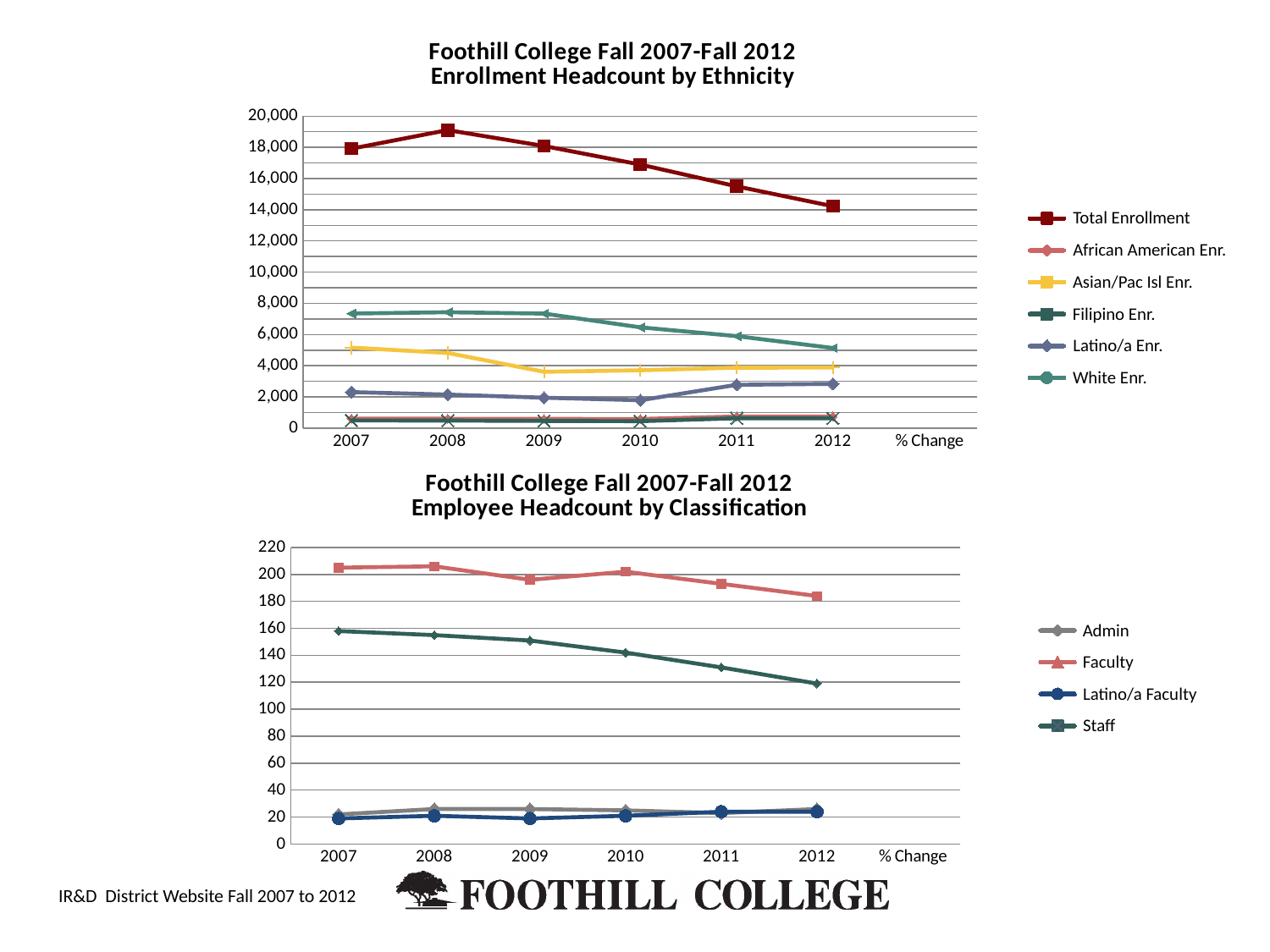
What kind of chart is the top chart, 'Enrollment Headcount by Ethnicity'? Line chart In the top chart, 'Enrollment Headcount by Ethnicity', in which year is Total Enrollment highest? 2008 In the bottom chart, 'Employee Headcount by Classification', does the Staff line rise or fall from 2007 to 2012? Fall In the bottom chart, 'Employee Headcount by Classification', how many series does the legend list? 4 In the top chart, 'Enrollment Headcount by Ethnicity', is the value for Total Enrollment in 2012 greater or less than 16,000? less In the top chart, 'Enrollment Headcount by Ethnicity', is the value for White Enr. in 2007 greater or less than 6,000? greater In the top chart, 'Enrollment Headcount by Ethnicity', how many years are plotted on the x axis? 6 In the top chart, 'Enrollment Headcount by Ethnicity', how many series does the legend list? 6 In the bottom chart, 'Employee Headcount by Classification', which is larger in 2012, Faculty or Staff? Faculty In the bottom chart, 'Employee Headcount by Classification', in which year is Faculty lowest? 2012 In the top chart, 'Enrollment Headcount by Ethnicity', in which year is Total Enrollment lowest? 2012 In the bottom chart, 'Employee Headcount by Classification', is the value for Staff in 2012 greater or less than 140? less